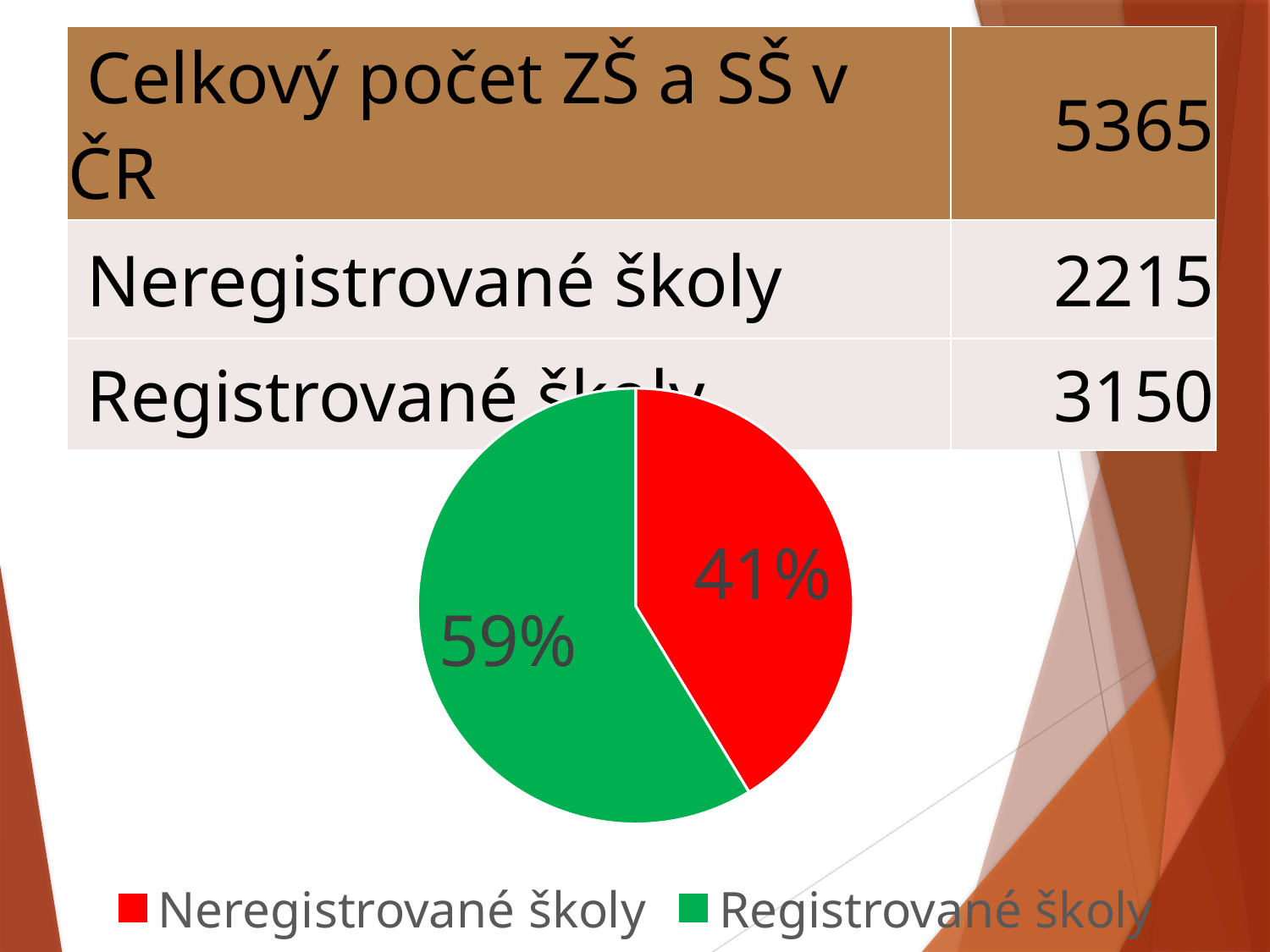
What colour is the Registrované školy slice in the pie chart? green How many slices does the pie chart have? 2 What type of chart is shown on the slide? pie chart What percentage of the pie chart is labelled for Registrované školy? 59% Which slice of the pie chart is the largest? Registrované školy By how many percentage points does the Registrované školy slice exceed the Neregistrované školy slice? 18 Which slice of the pie chart is the smallest? Neregistrované školy What colour is the Neregistrované školy slice in the pie chart? red How many entries does the legend of the pie chart list? 2 What percentage of the pie chart is labelled for Neregistrované školy? 41% Which is larger in the pie chart, Neregistrované školy or Registrované školy? Registrované školy What share of the pie does the Registrované školy slice represent? 59%